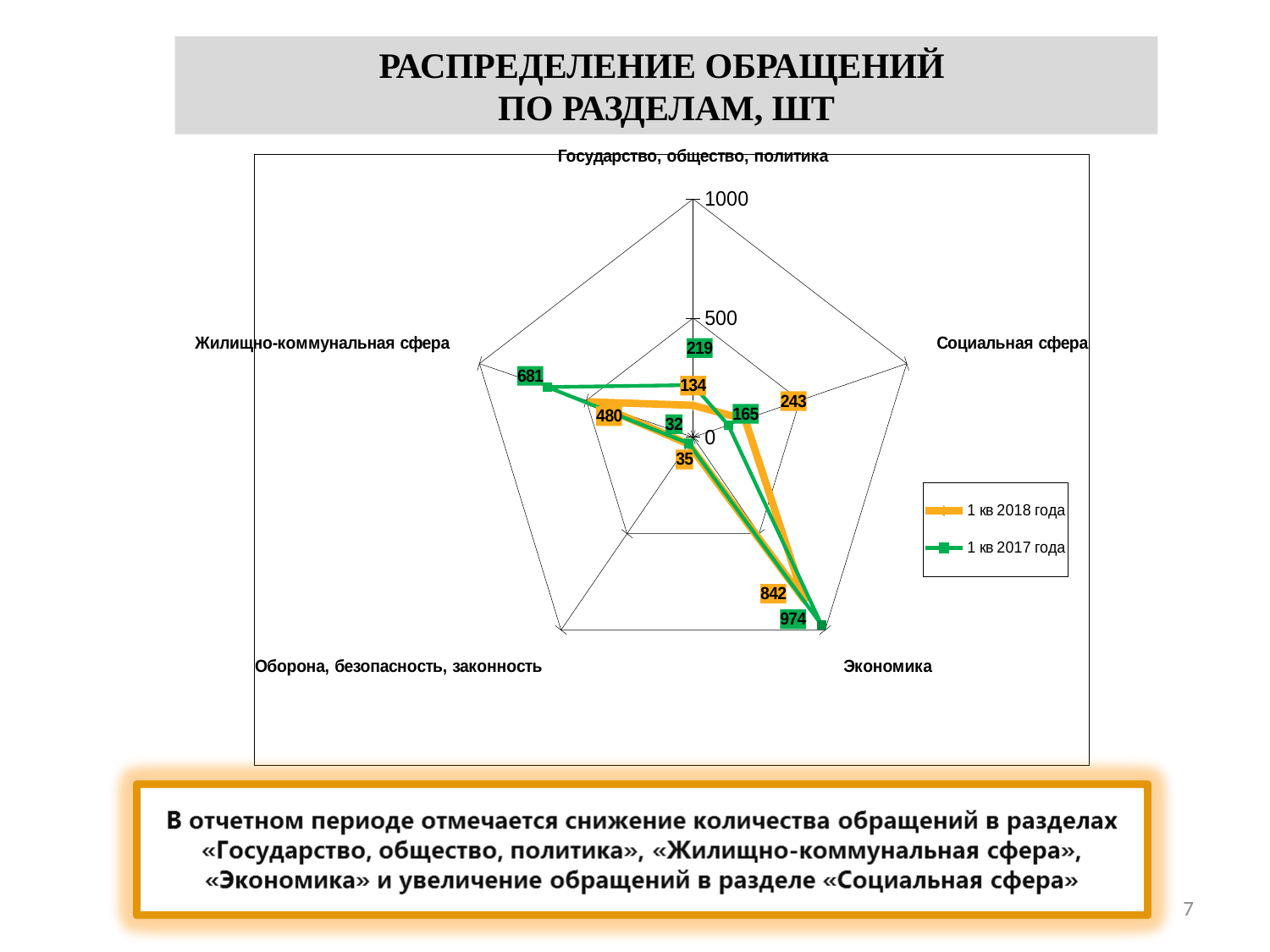
What kind of chart is shown on the slide? Radar chart What is the value for «Государство, общество, политика» in the series «1 кв 2017 года»? 219 How many categories (axes) does the radar chart have? 5 Which category has the lowest value in the series «1 кв 2017 года»? Оборона, безопасность, законность What is the value for «Экономика» in the series «1 кв 2017 года»? 974 What is the title of the chart on the slide? РАСПРЕДЕЛЕНИЕ ОБРАЩЕНИЙ ПО РАЗДЕЛАМ, ШТ What is the difference between the «1 кв 2017 года» and «1 кв 2018 года» values for «Жилищно-коммунальная сфера»? 201 How many series does the legend list? 2 For «Социальная сфера», which series has the larger value: «1 кв 2018 года» or «1 кв 2017 года»? 1 кв 2018 года What is the value for «Социальная сфера» in the series «1 кв 2018 года»? 243 Which category has the highest value in the series «1 кв 2018 года»? Экономика What is the value for «Жилищно-коммунальная сфера» in the series «1 кв 2018 года»? 480